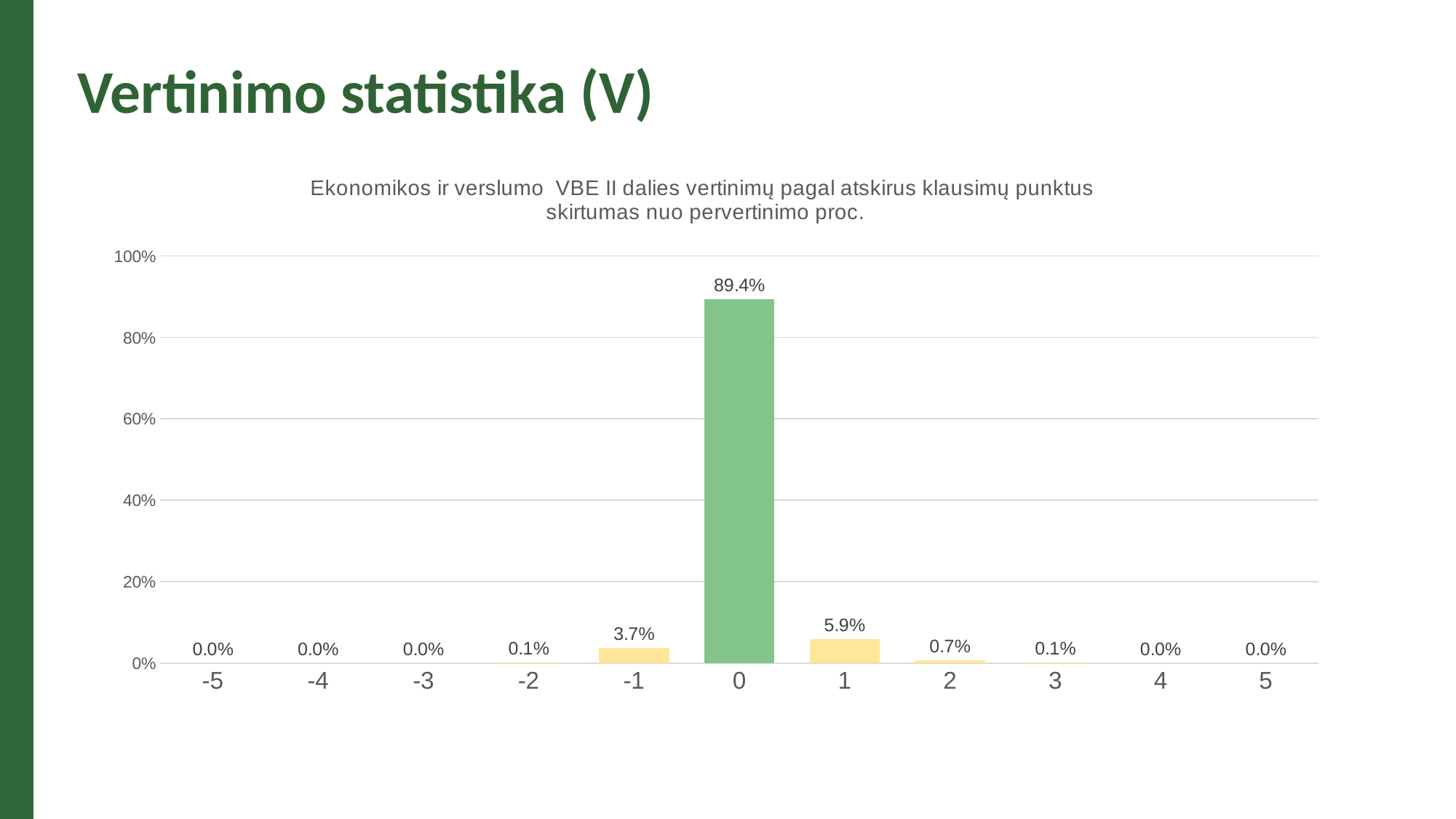
How many categories are shown on the x axis? 11 What is the value for category -1? 3.7% What is the value for category 0? 89.4% Which is larger, the value for category 1 or the value for category -1? 1 What is the value for category 2? 0.7% What is the value for category 1? 5.9% What is the difference between the values for category 1 and category -1? 2.2% What colour is the bar for category 0? green What is the value for category -2? 0.1% What kind of chart is shown on the slide? bar chart Is the value for category 0 greater or less than 80%? greater Which category has the highest value? 0